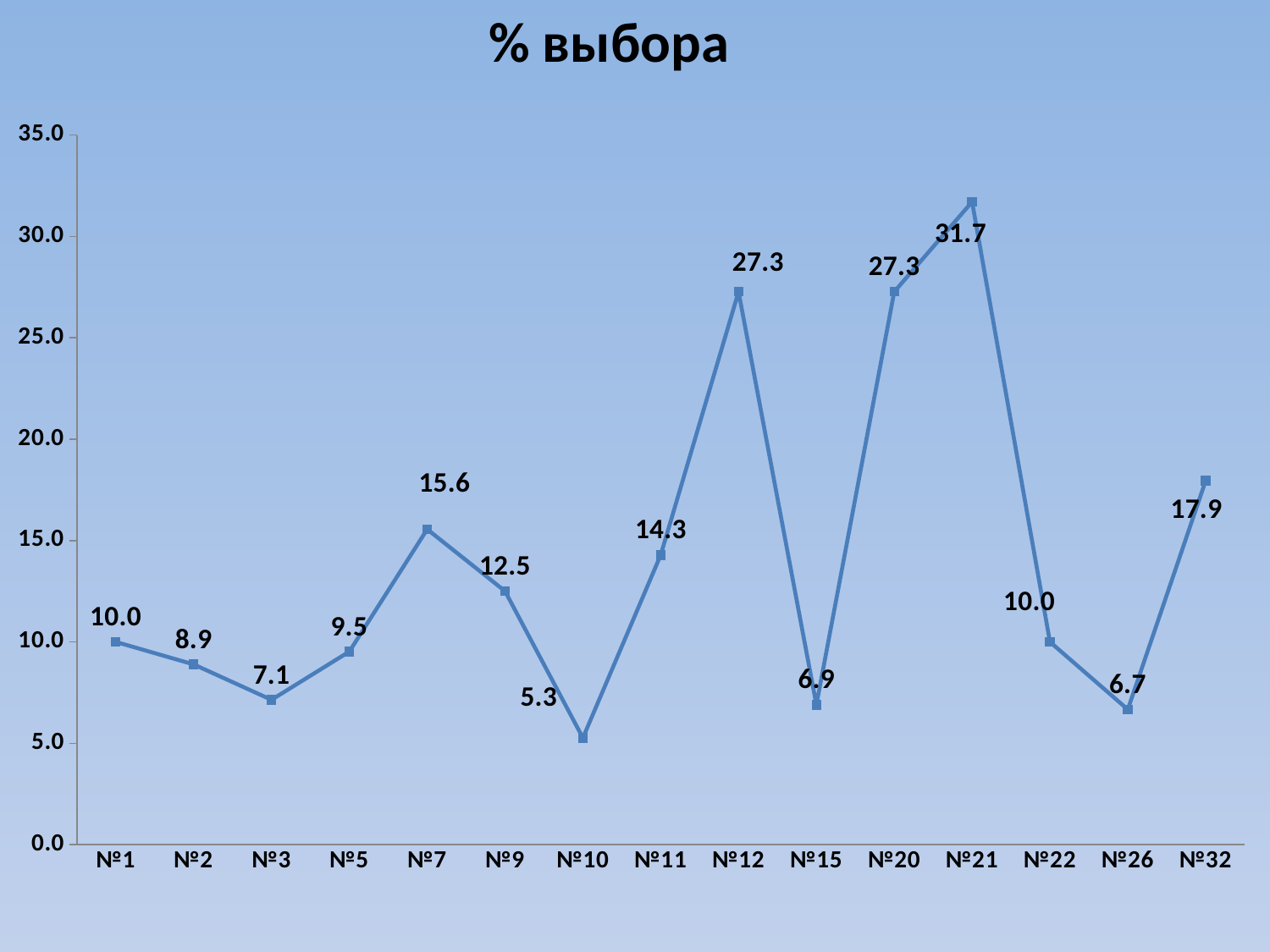
What is the value for №12? 27.3 What is the title of the chart? % выбора What is the difference between the values for №32 and №22? 7.9 Which category has the lowest value? №10 What is the value for №7? 15.6 Is the value for №15 greater or less than 10.0? less Which category has the highest value? №21 What kind of chart is shown? line chart What is the difference between the values for №21 and №20? 4.4 What is the value for №26? 6.7 Which is larger, the value for №11 or the value for №9? №11 How many categories are plotted on the x axis? 15